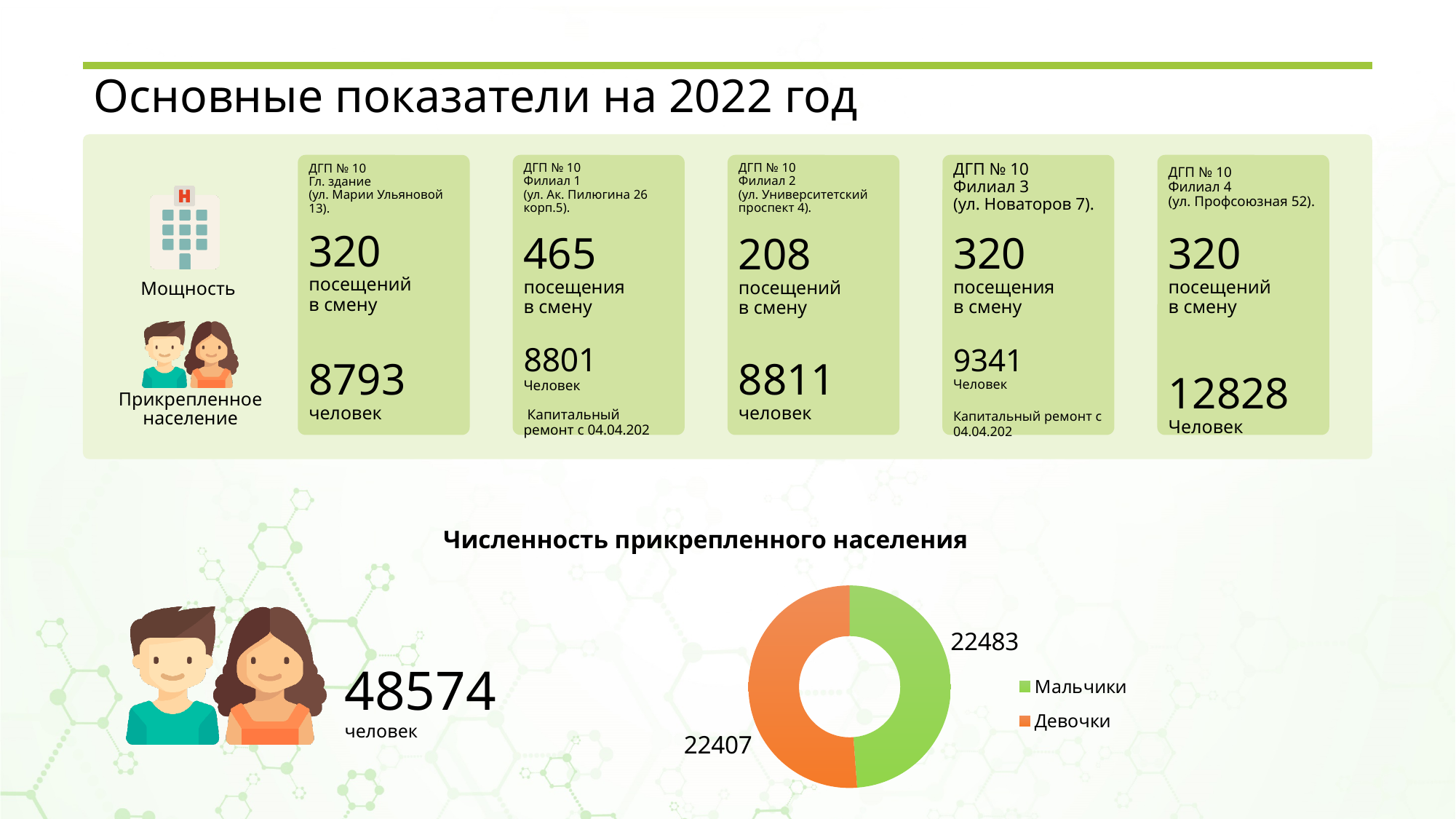
What kind of chart is 'Численность прикрепленного населения'? Pie (donut) chart What is the title of the chart on the slide? Численность прикрепленного населения What is the value for Мальчики in the chart 'Численность прикрепленного населения'? 22483 Is the value for Мальчики larger or smaller than the value for Девочки in the chart 'Численность прикрепленного населения'? larger How many categories are shown in the chart 'Численность прикрепленного населения'? 2 What is the difference between the values for Мальчики and Девочки in the chart 'Численность прикрепленного населения'? 76 What colour represents Девочки in the chart 'Численность прикрепленного населения'? Orange Which category has the smaller value in the chart 'Численность прикрепленного населения'? Девочки What is the value for Девочки in the chart 'Численность прикрепленного населения'? 22407 Which category has the larger value in the chart 'Численность прикрепленного населения'? Мальчики How many entries does the legend of the chart 'Численность прикрепленного населения' list? 2